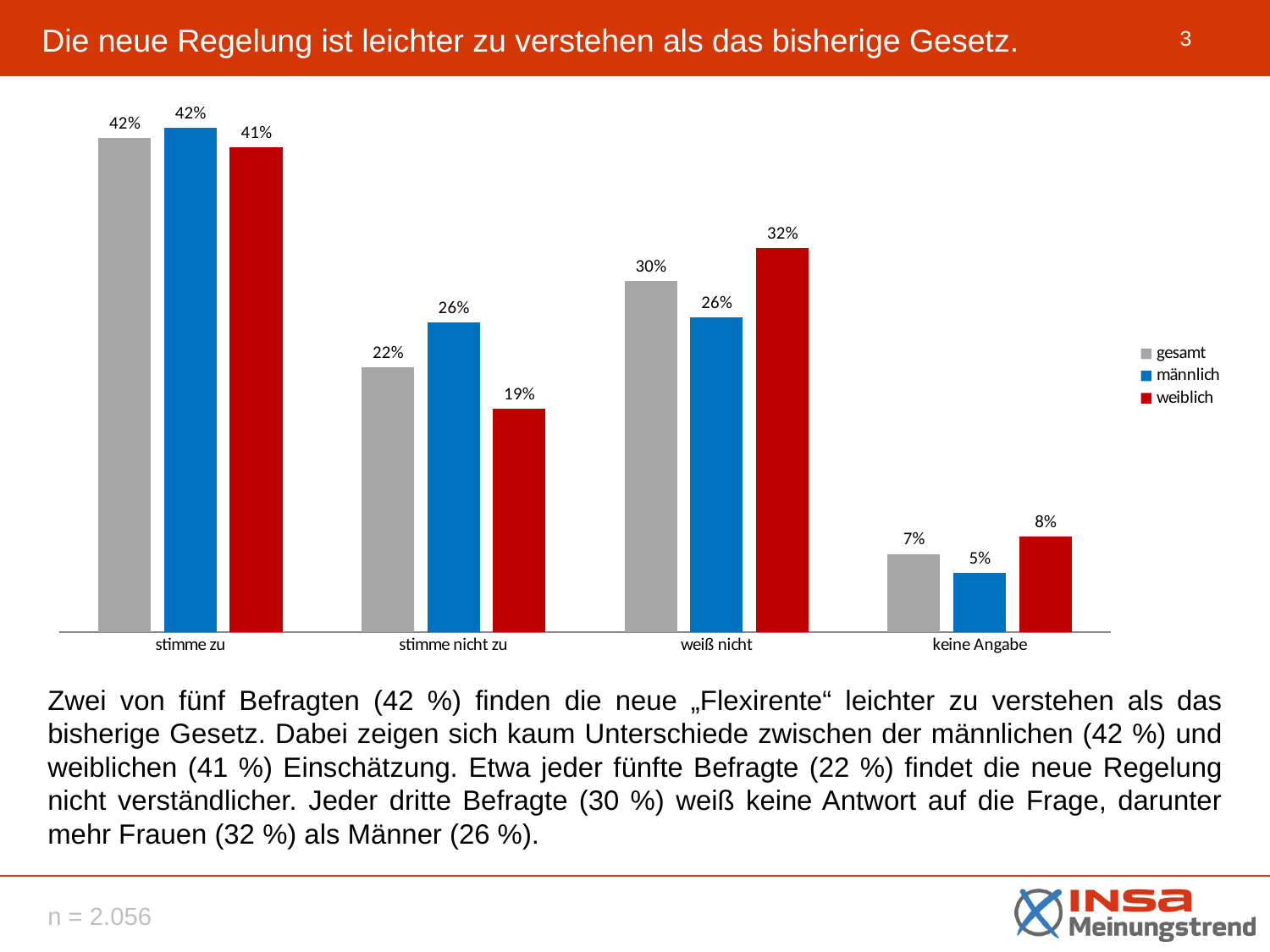
What is the difference between the "männlich" and "weiblich" values in the "weiß nicht" category? 6% What is the value for "weiblich" in the "stimme nicht zu" category? 19% What is the difference between the "gesamt" values for "stimme zu" and "stimme nicht zu"? 20% Which category has the highest value for the "weiblich" series? stimme zu What is the value for "gesamt" in the "stimme zu" category? 42% What kind of chart is shown on the slide? bar chart How many series does the legend list? 3 How many categories are shown on the x axis? 4 Which category has the lowest value for the "gesamt" series? keine Angabe In the "stimme nicht zu" category, which is larger: the value for "männlich" or for "weiblich"? männlich Which series is shown in red in the legend? weiblich What is the value for "männlich" in the "keine Angabe" category? 5%